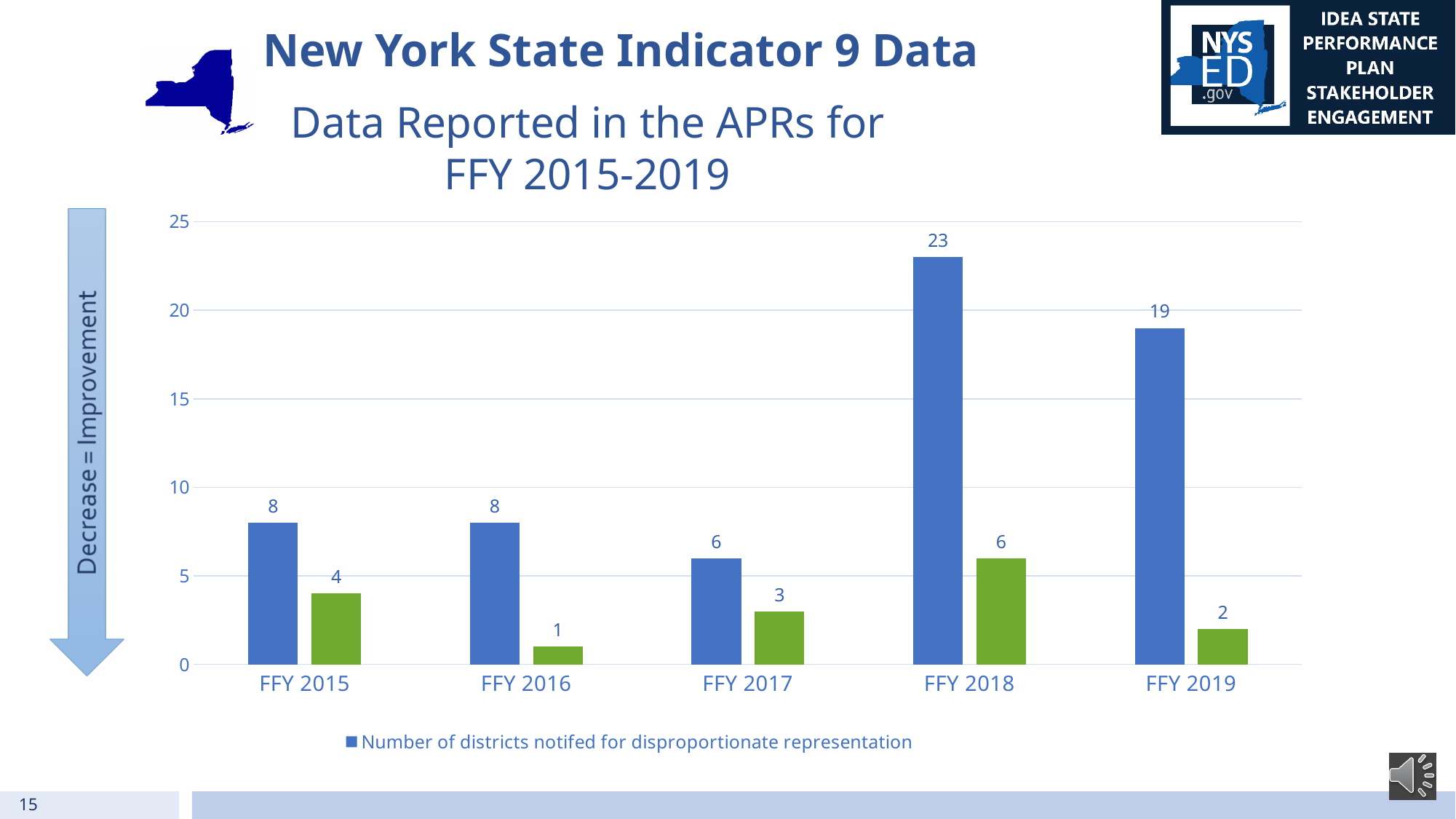
What kind of chart is shown on the slide? bar chart What value is shown on the green bar for FFY 2018? 6 What is the number of districts notified for disproportionate representation in FFY 2019? 19 Is the number of districts notified for disproportionate representation in FFY 2018 greater or less than 20? greater Which FFY has the lowest number of districts notified for disproportionate representation? FFY 2017 How many series does the legend list? 1 Which is larger: the number of districts notified for disproportionate representation in FFY 2015 or in FFY 2017? FFY 2015 What is the difference between the number of districts notified for disproportionate representation in FFY 2018 and FFY 2019? 4 What is the legend entry shown below the chart? Number of districts notifed for disproportionate representation What is the number of districts notified for disproportionate representation in FFY 2018? 23 Which FFY has the highest number of districts notified for disproportionate representation? FFY 2018 How many FFY categories are shown on the x axis? 5